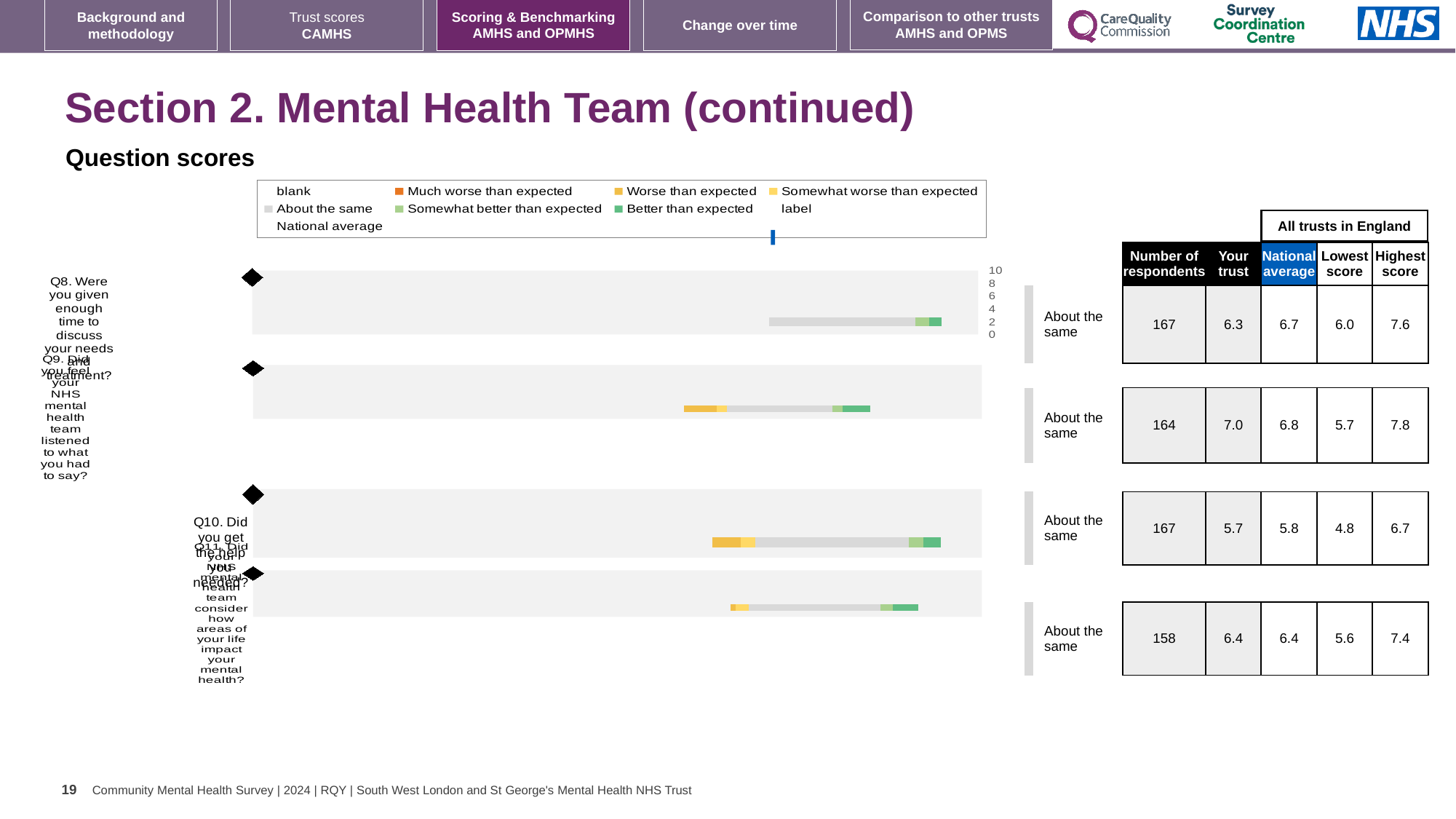
What is the 'Your trust' score for Q8 (Were you given enough time to discuss your needs and treatment?)? 6.3 Which question has the lowest 'Your trust' score? Q10 How many entries does the legend above the question scores charts list? 9 For Q8, which is larger: the 'Your trust' score or the national average? National average What colour does the legend use for 'Much worse than expected'? orange For Q9, how much higher is the 'Your trust' score than the national average? 0.2 How many questions (Q8 to Q11) are plotted in the question scores charts? 4 What is the highest score among all trusts in England for Q9? 7.8 How many respondents answered Q11 (Did your NHS mental health team consider how areas of your life impact your mental health?)? 158 What kind of chart is used to show the question scores on this slide? bar chart What is the national average score for Q9 (Did you feel your NHS mental health team listened to what you had to say?)? 6.8 Which question has the highest 'Your trust' score? Q9